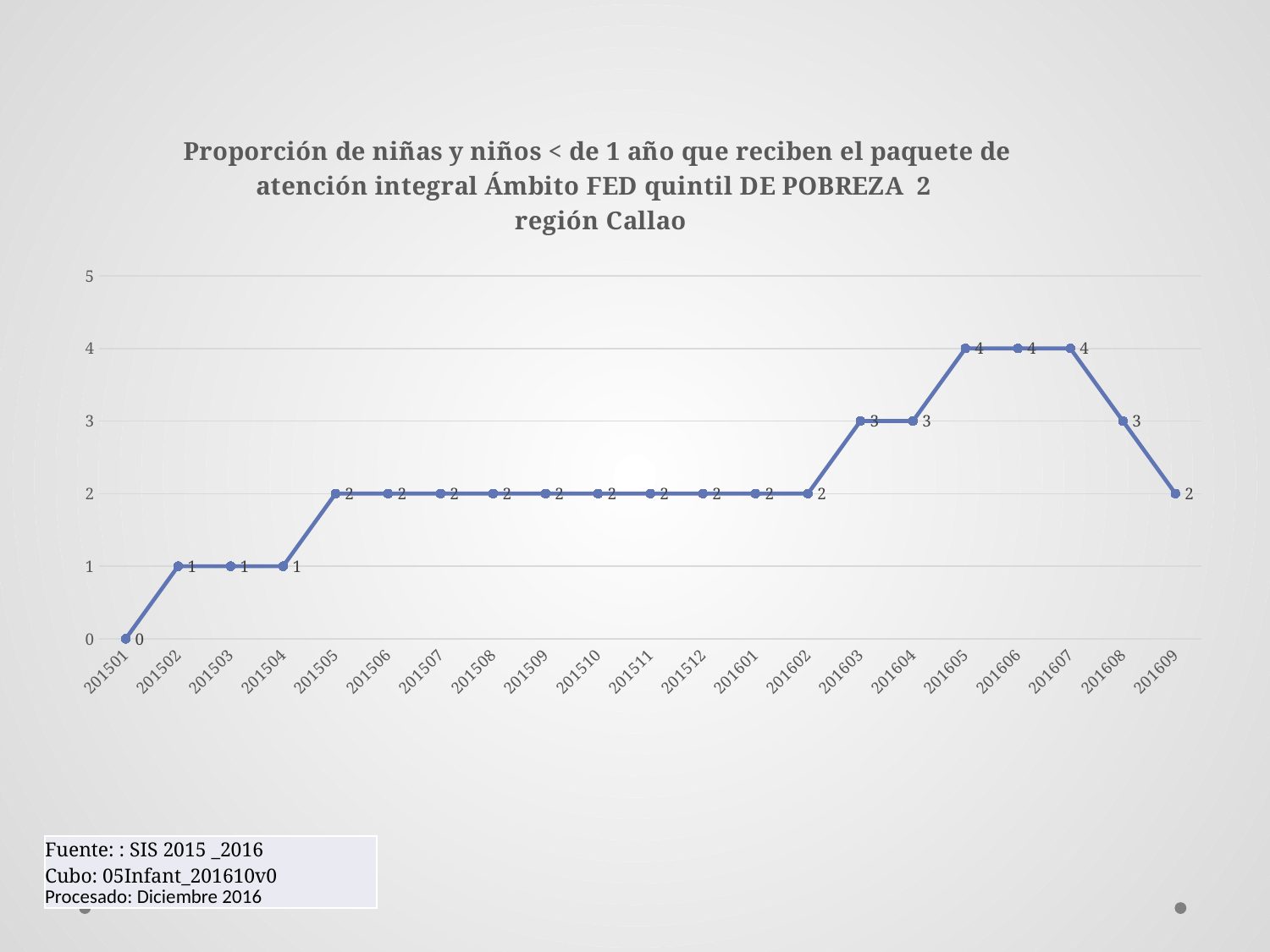
Which period has the lowest value? 201501 What is the value for 201605? 4 What is the value for 201609? 2 What is the value for 201501? 0 What is the highest value plotted on the chart? 4 Does the value rise or fall from 201607 to 201609? fall What kind of chart is shown on the slide? line chart Which is larger, the value for 201504 or the value for 201604? 201604 What is the value for 201603? 3 How many data points are plotted on the chart? 21 Which region is named in the chart title? Callao What is the difference between the values for 201607 and 201608? 1